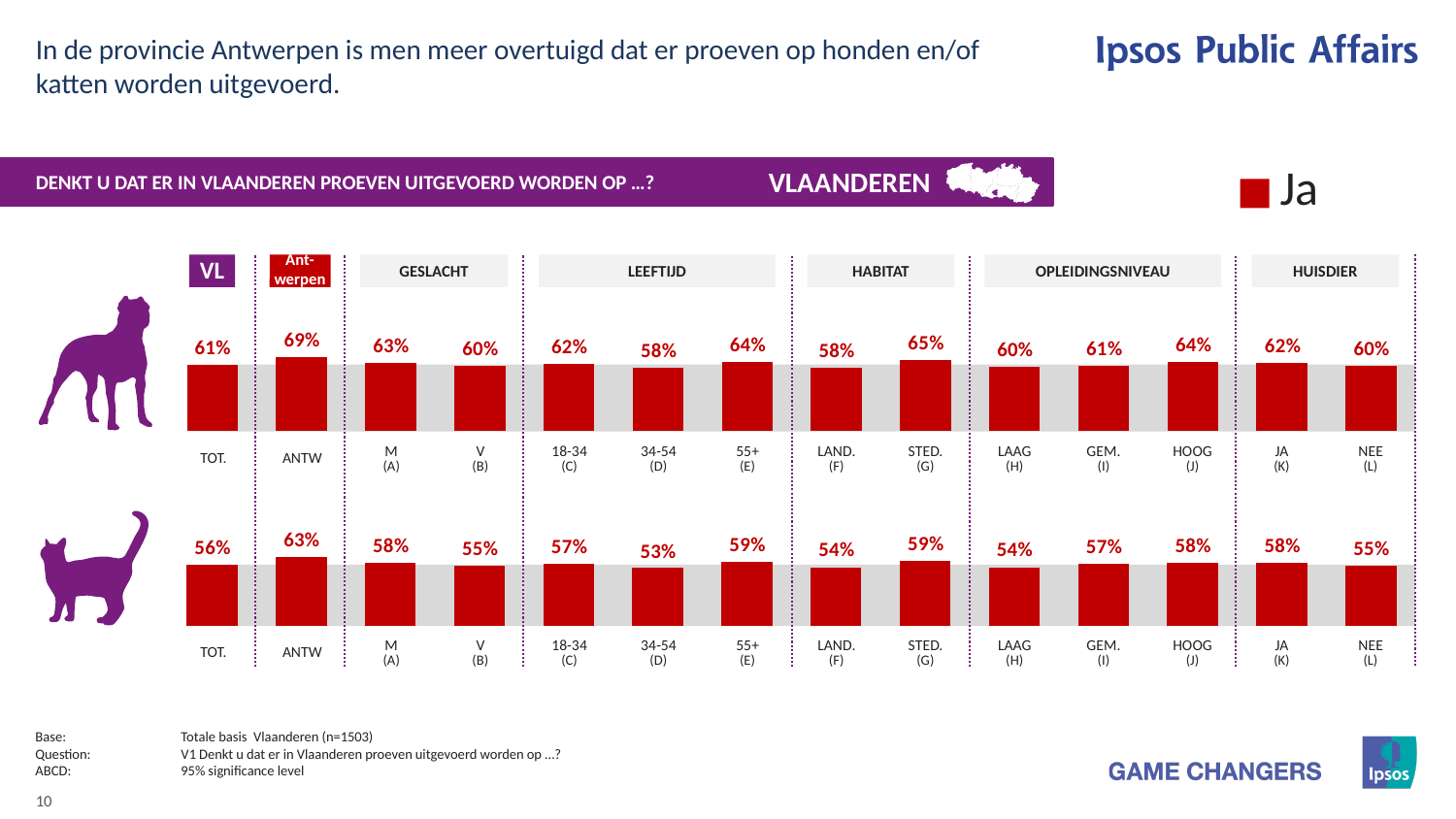
In the bottom row of bars (cat icon), what is the value for 34-54 (D)? 53% In the bottom row of bars (cat icon), what is the value for STED. (G)? 59% In the top row of bars (dog icon), what is the value for ANTW? 69% In the bottom row of bars (cat icon), what is the difference between the values for M (A) and V (B)? 3% What is the single legend entry shown at the top right of the slide? Ja How many categories (bars) are shown in the bottom row of bars (cat icon)? 14 In the top row of bars (dog icon), what is the value for TOT.? 61% In the bottom row of bars (cat icon), which category has the lowest value? 34-54 (D) In the top row of bars (dog icon), what is the difference between the values for ANTW and TOT.? 8% In the top row of bars (dog icon), which is larger: the value for LAND. (F) or STED. (G)? STED. (G) In the top row of bars (dog icon), which category has the highest value? ANTW What kind of chart is used on this slide? Bar chart